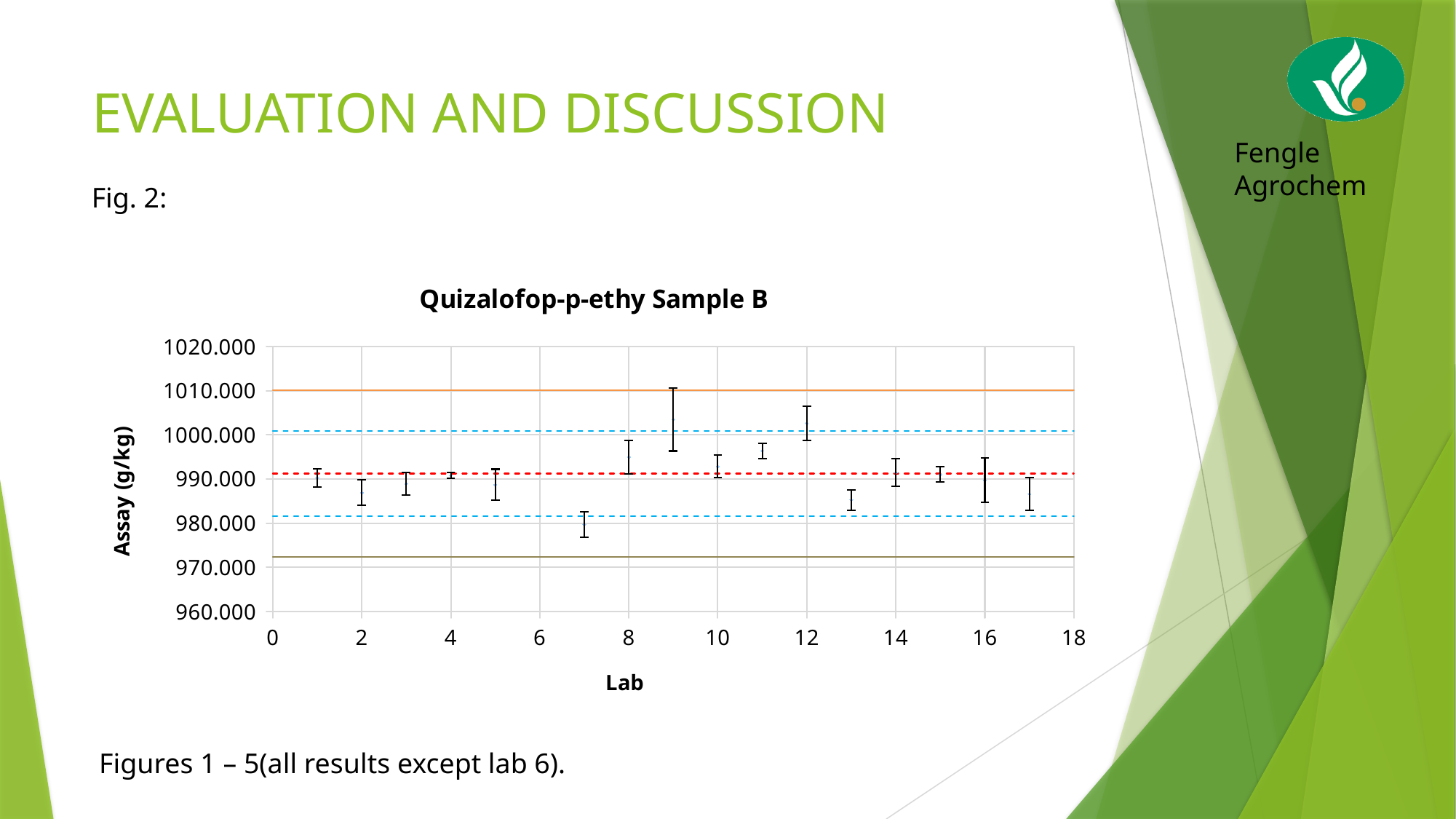
Is the assay value for lab 11 greater or less than 990? greater What type of chart is shown on the slide? Scatter chart with error bars How many labs have results plotted on the chart? 16 Which has the larger assay value, lab 7 or lab 9? Lab 9 What is the label of the vertical axis of the chart? Assay (g/kg) Is the assay value for lab 7 greater or less than 990? less Which has the larger assay value, lab 13 or lab 11? Lab 11 Which lab has the lowest assay value on the chart? Lab 7 What is the title of the chart? Quizalofop-p-ethy Sample B Is the assay value for lab 13 greater or less than 990? less